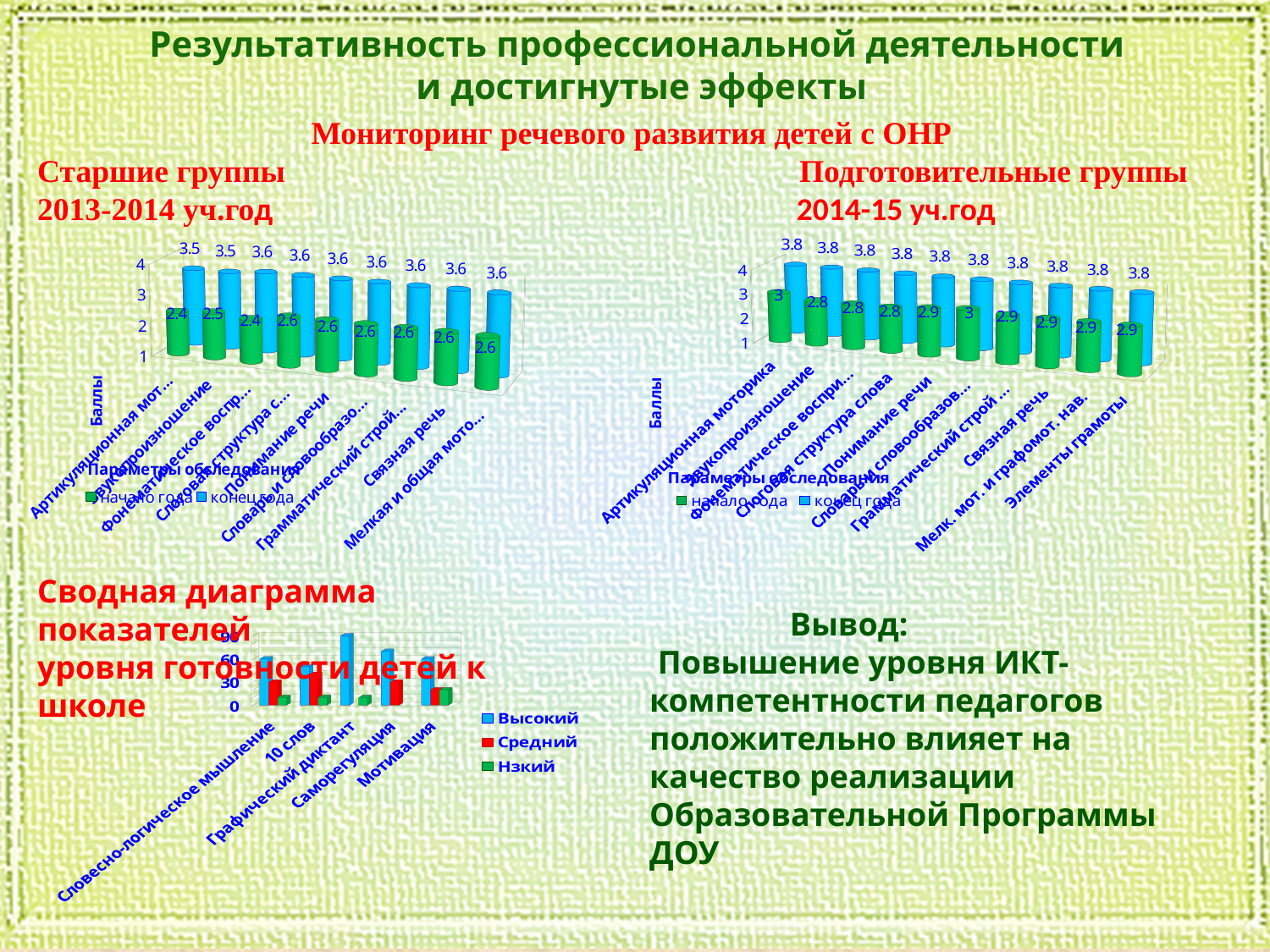
In the chart for Подготовительные группы 2014-15 уч.год, what is the value of конец года for Элементы грамоты? 3.8 In the chart for Старшие группы 2013-2014 уч.год, what is the value of конец года for Понимание речи? 3.6 In the bottom-left chart (Сводная диаграмма показателей уровня готовности детей к школе), how many series does the legend list? 3 In the chart for Подготовительные группы 2014-15 уч.год, how many categories are shown on the x axis? 10 In the chart for Подготовительные группы 2014-15 уч.год, what is the value of начало года for Артикуляционная моторика? 3 In the chart for Старшие группы 2013-2014 уч.год, how many series does the legend list? 2 In the bottom-left chart (Сводная диаграмма показателей уровня готовности детей к школе), is the value of Высокий for Графический диктант greater or less than 60? greater In the chart for Старшие группы 2013-2014 уч.год, what is the value of начало года for Звукопроизношение? 2.5 In the chart for Подготовительные группы 2014-15 уч.год, what is the difference between конец года and начало года for Звукопроизношение? 1 In the chart for Старшие группы 2013-2014 уч.год, how many categories are shown on the x axis? 9 In the chart for Старшие группы 2013-2014 уч.год, what is the difference between конец года and начало года for Связная речь? 1 In the chart for Подготовительные группы 2014-15 уч.год, which is larger for Связная речь: начало года or конец года? конец года